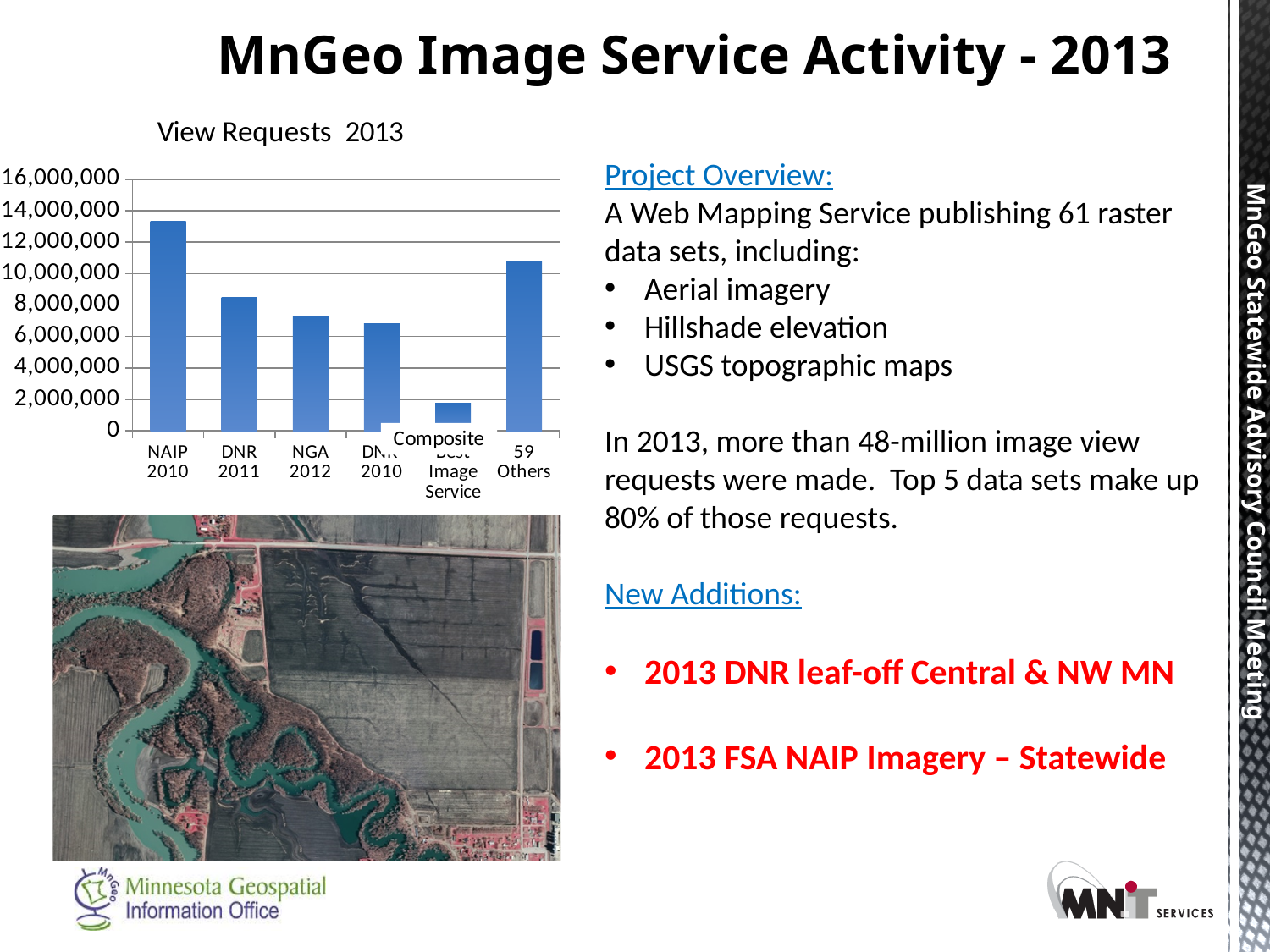
Which category has the lowest number of view requests in the "View Requests 2013" chart? Composite Best Image Service How many categories are shown on the x axis of the "View Requests 2013" chart? 6 What is the title of the bar chart on the slide? View Requests 2013 In the "View Requests 2013" chart, which has more view requests, 59 Others or DNR 2010? 59 Others In the "View Requests 2013" chart, is the value for NAIP 2010 greater or less than 12,000,000? greater What kind of chart is the "View Requests 2013" chart? bar chart In the "View Requests 2013" chart, is the value for Composite Best Image Service greater or less than 2,000,000? less In the "View Requests 2013" chart, is the value for DNR 2011 greater or less than 10,000,000? less In the "View Requests 2013" chart, which has more view requests, DNR 2011 or NGA 2012? DNR 2011 Which category has the highest number of view requests in the "View Requests 2013" chart? NAIP 2010 What is the maximum value shown on the y axis of the "View Requests 2013" chart? 16,000,000